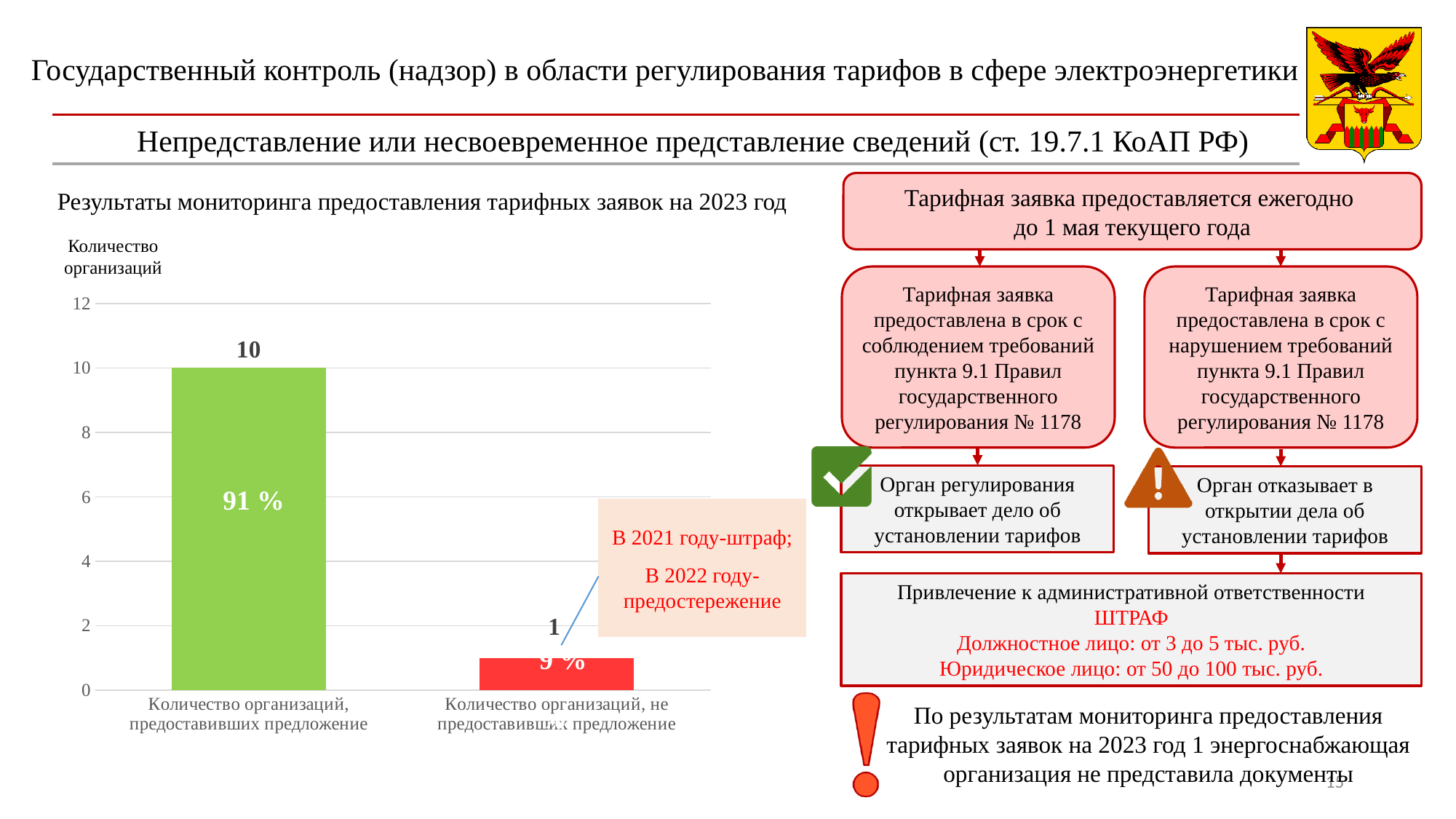
What is the difference between the number of organisations that submitted a proposal and those that did not? 9 What percentage label is shown on the green bar for organisations that submitted a proposal? 91 % What is the value for 'Количество организаций, не предоставивших предложение'? 1 What is the value for 'Количество организаций, предоставивших предложение'? 10 Which category has the lowest value? Количество организаций, не предоставивших предложение What kind of chart is shown on the slide? bar chart What is the title of the chart? Результаты мониторинга предоставления тарифных заявок на 2023 год How many categories are shown on the x axis of the chart? 2 Which category has the highest value? Количество организаций, предоставивших предложение What is the label of the vertical axis of the chart? Количество организаций Which is larger: the number of organisations that submitted a proposal or the number that did not? Количество организаций, предоставивших предложение Is the value for 'Количество организаций, предоставивших предложение' greater or less than 8? greater